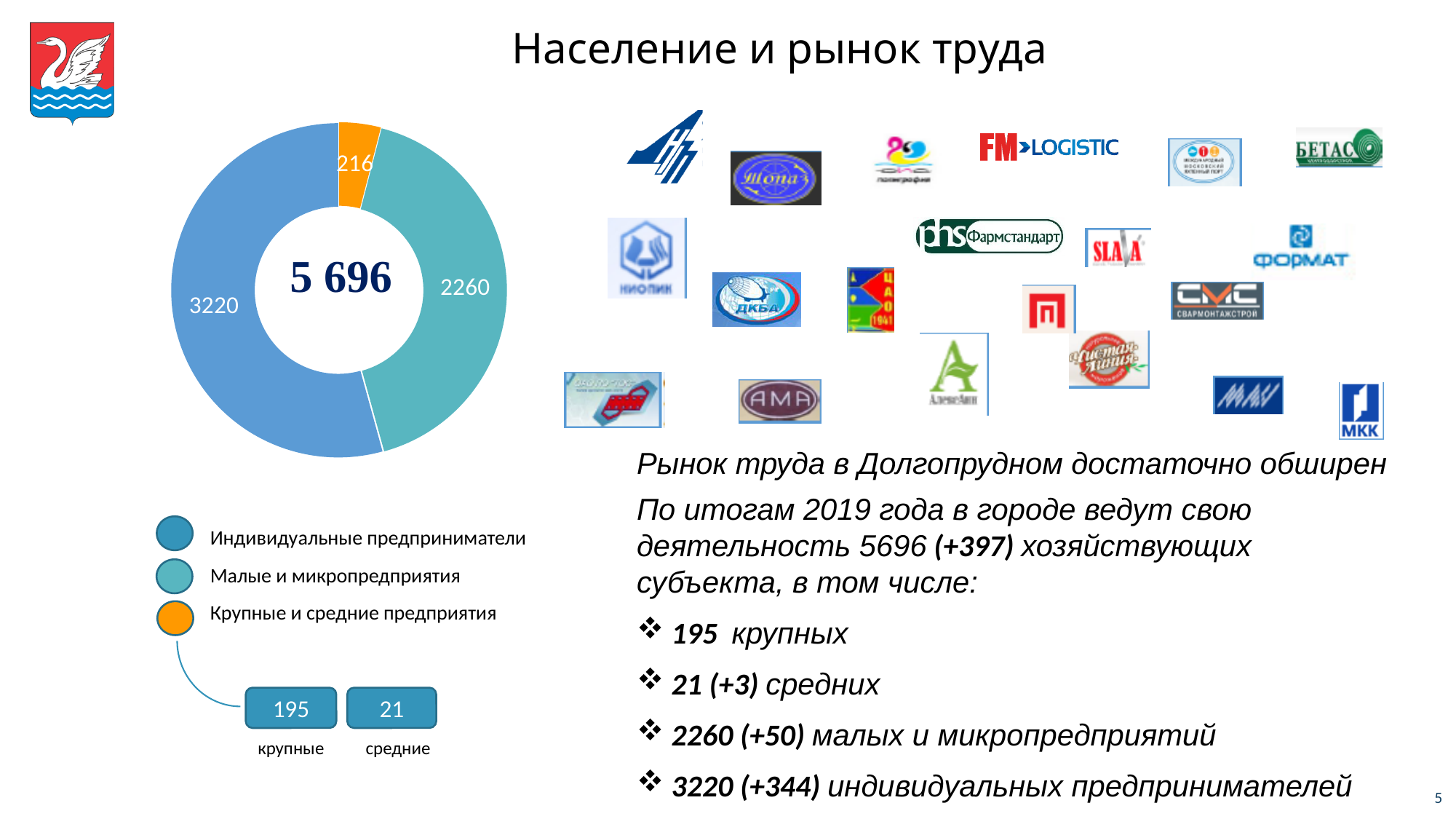
What value is shown for Малые и микропредприятия in the doughnut chart? 2260 What is the difference between the values for Индивидуальные предприниматели and Малые и микропредприятия? 960 What value is shown for Индивидуальные предприниматели in the doughnut chart? 3220 Which is larger: the value for Малые и микропредприятия or for Крупные и средние предприятия? Малые и микропредприятия Which colour represents Крупные и средние предприятия in the chart legend? orange Which category has the smallest segment in the doughnut chart? Крупные и средние предприятия How many categories does the doughnut chart show? 3 What total is printed in the centre of the doughnut chart? 5 696 What kind of chart is shown on the left of the slide? doughnut chart What value is shown for Крупные и средние предприятия in the doughnut chart? 216 What is the difference between the values for Малые и микропредприятия and Крупные и средние предприятия? 2044 Which category has the largest segment in the doughnut chart? Индивидуальные предприниматели